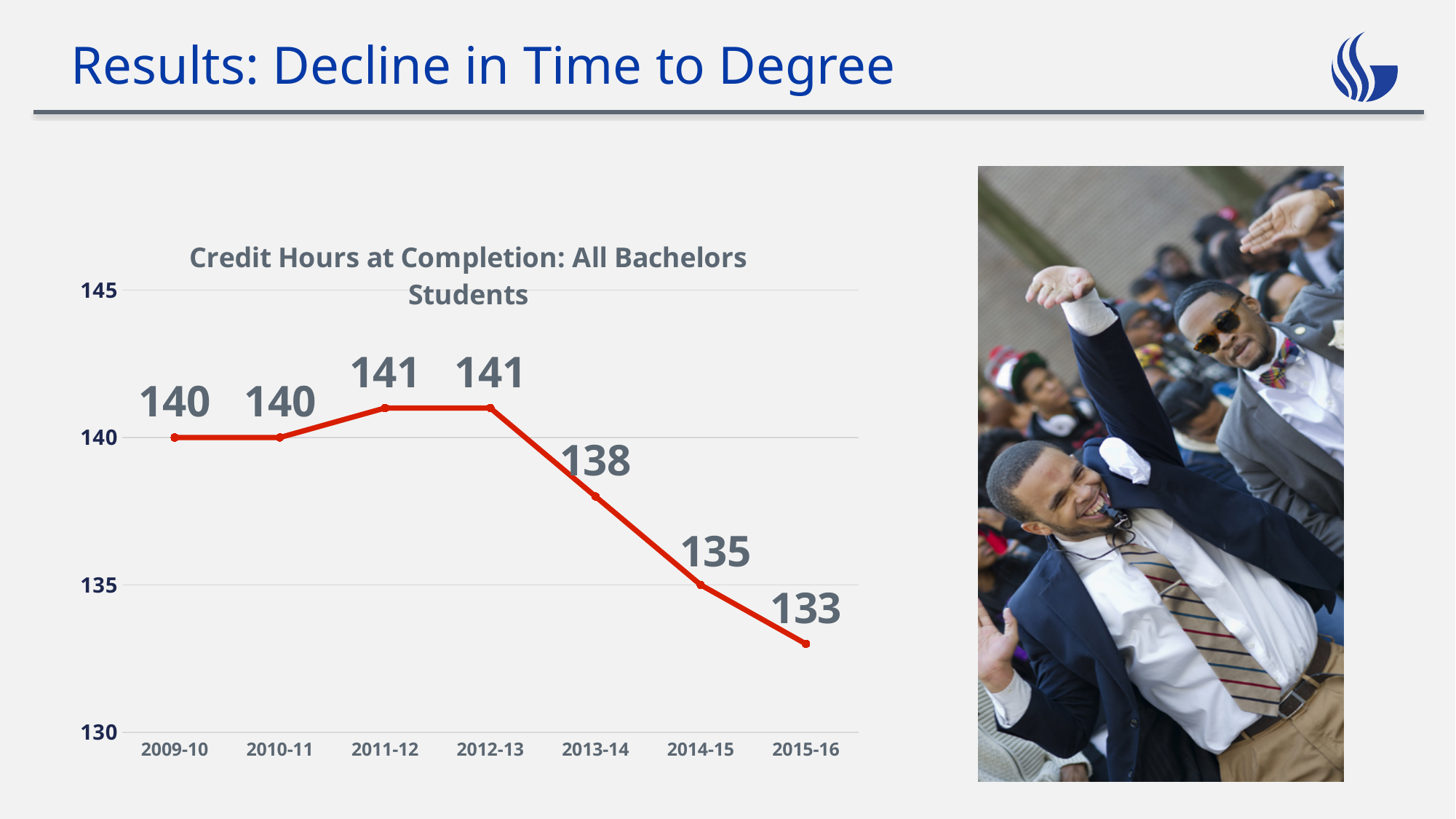
What is the value for 2015-16? 133 What is the difference between the values for 2012-13 and 2015-16? 8 How many years are plotted on the chart? 7 What is the title of the chart? Credit Hours at Completion: All Bachelors Students Is the value for 2014-15 greater or less than 140? less Do the values rise or fall from 2012-13 to 2015-16? fall What is the difference between the values for 2013-14 and 2014-15? 3 Which is larger, the value for 2011-12 or the value for 2014-15? 2011-12 What is the value for 2013-14? 138 What kind of chart is shown on the slide? line chart What is the value for 2009-10? 140 Which year has the lowest credit hours at completion? 2015-16